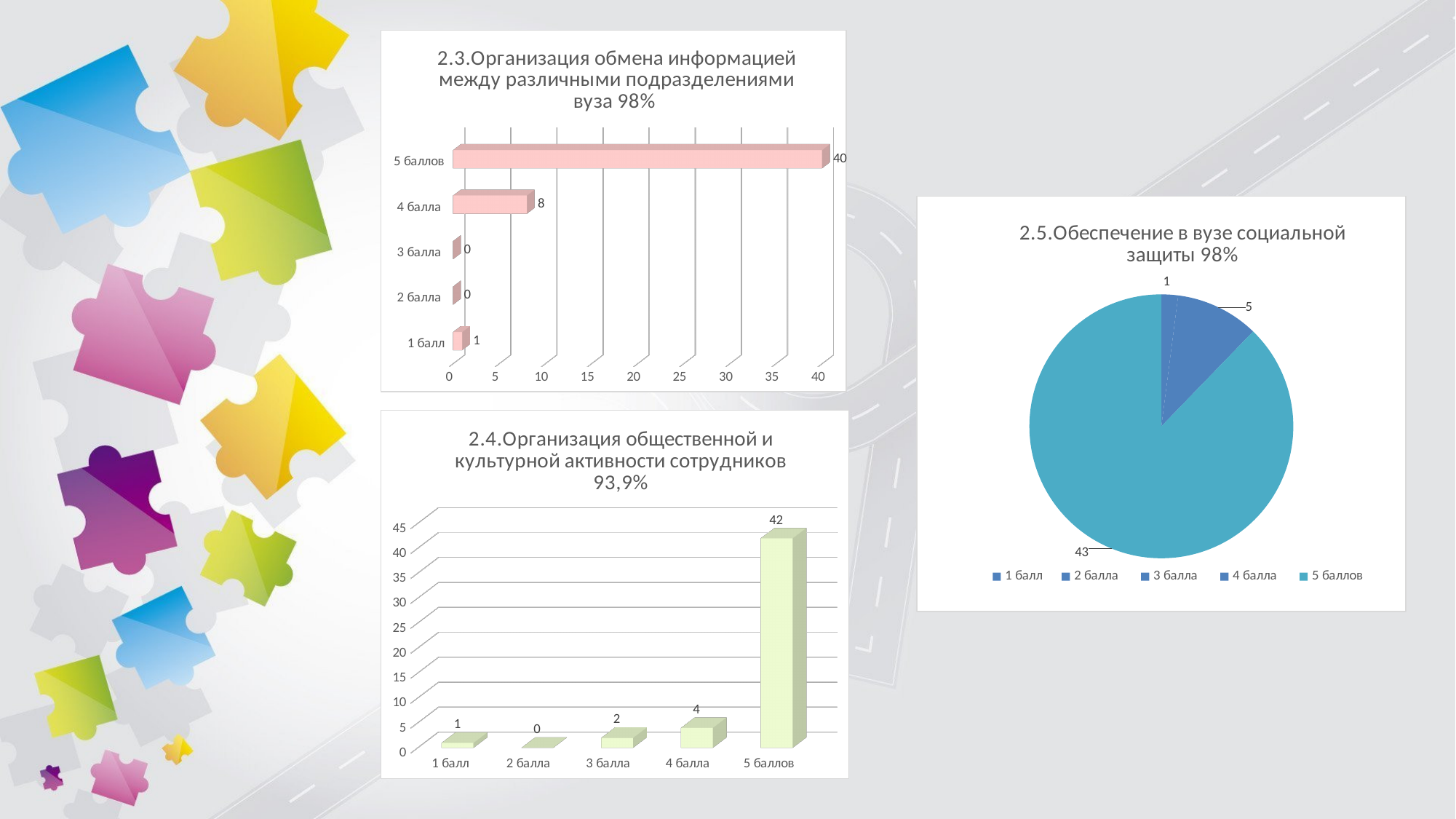
In the chart '2.3.Организация обмена информацией между различными подразделениями вуза 98%', what is the difference between the values for 5 баллов and 4 балла? 32 What kind of chart is '2.5.Обеспечение в вузе социальной защиты 98%'? pie chart In the chart '2.4.Организация общественной и культурной активности сотрудников 93,9%', which category has the lowest value? 2 балла In the chart '2.4.Организация общественной и культурной активности сотрудников 93,9%', what is the difference between the values for 4 балла and 1 балл? 3 What kind of chart is '2.3.Организация обмена информацией между различными подразделениями вуза 98%'? bar chart In the chart '2.4.Организация общественной и культурной активности сотрудников 93,9%', which is larger, the value for 3 балла or 4 балла? 4 балла In the chart '2.3.Организация обмена информацией между различными подразделениями вуза 98%', what is the value for 4 балла? 8 In the chart '2.4.Организация общественной и культурной активности сотрудников 93,9%', what is the value for 5 баллов? 42 In the chart '2.5.Обеспечение в вузе социальной защиты 98%', what is the value of the largest slice? 43 In the chart '2.3.Организация обмена информацией между различными подразделениями вуза 98%', what is the value for 5 баллов? 40 How many entries does the legend of the chart '2.5.Обеспечение в вузе социальной защиты 98%' list? 5 In the chart '2.3.Организация обмена информацией между различными подразделениями вуза 98%', how many categories are shown? 5